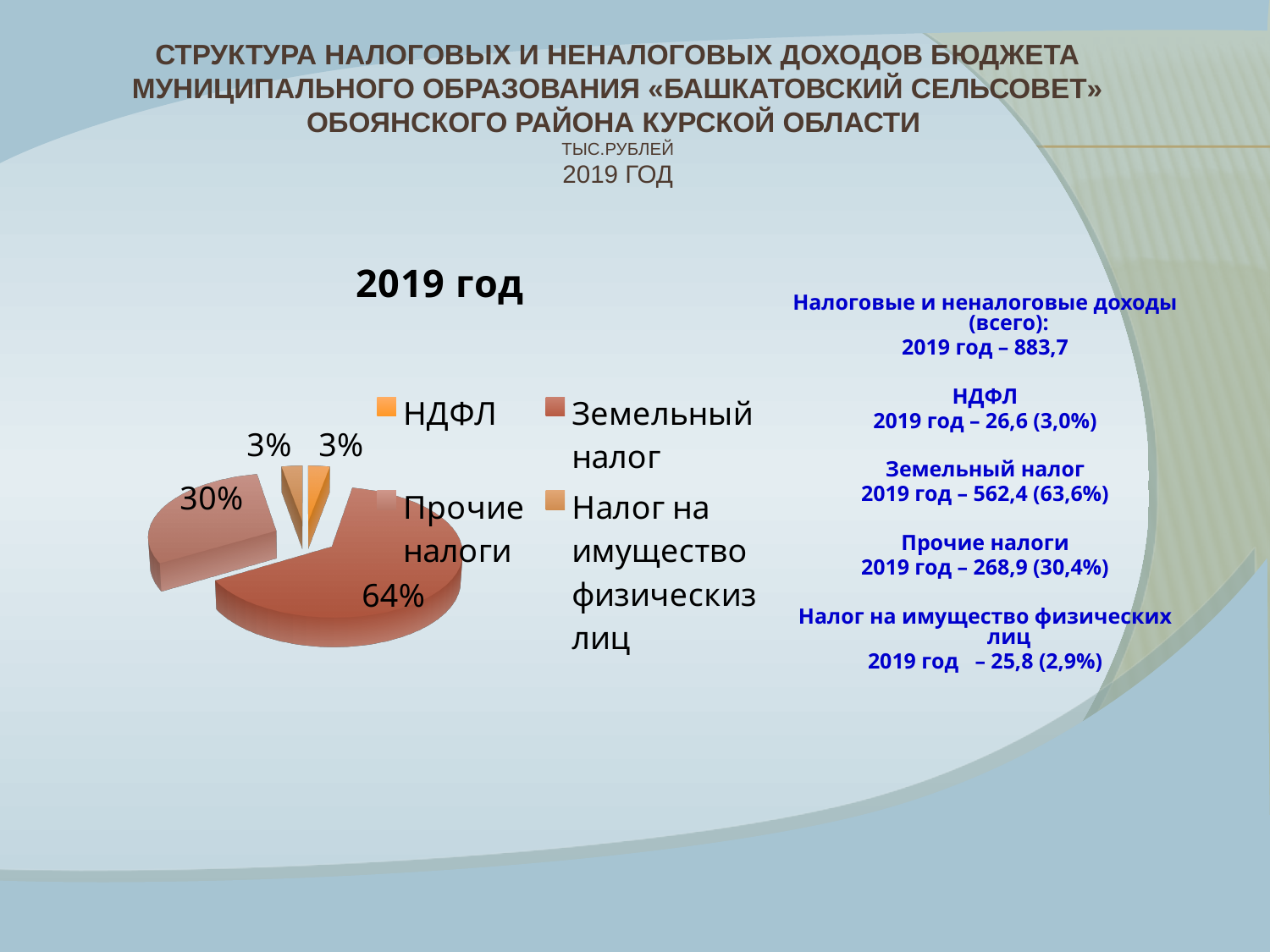
What share of the pie does Прочие налоги have? 30% Which is larger, the slice for Прочие налоги or the slice for НДФЛ? Прочие налоги What is the title of the chart? 2019 год What share of the pie does Земельный налог have? 64% Which category has the largest slice of the pie? Земельный налог How many entries does the chart legend list? 4 What share of the pie does НДФЛ have? 3% By how many percentage points does the Земельный налог slice exceed the Прочие налоги slice? 34 How many slices does the pie chart have? 4 Which is larger, the slice for Земельный налог or the slice for Прочие налоги? Земельный налог What share of the pie does Налог на имущество физических лиц have? 3% What kind of chart is shown on the slide? pie chart